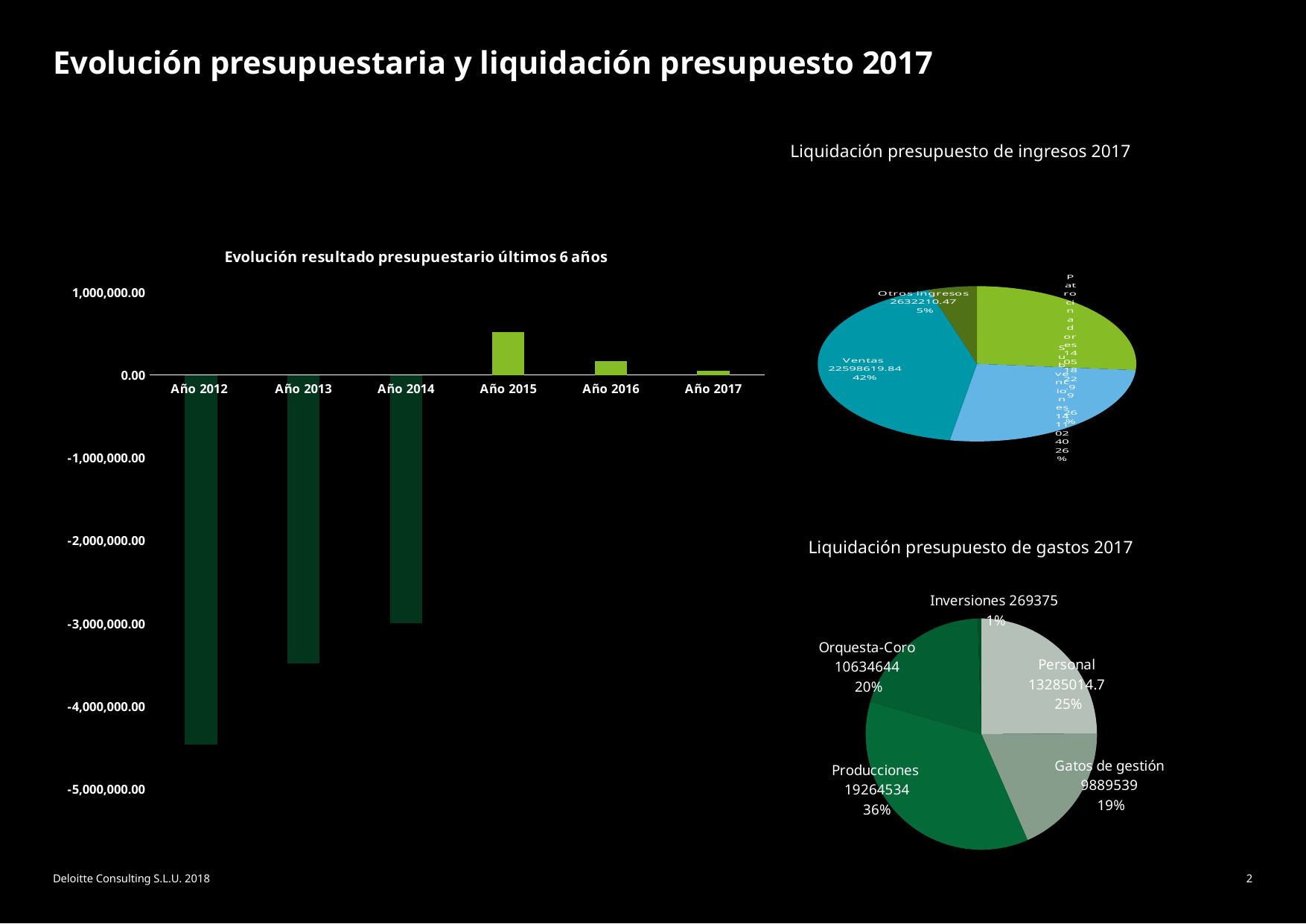
In the chart 'Evolución resultado presupuestario últimos 6 años', is the value for Año 2012 greater or less than -4,000,000.00? less In the pie chart 'Liquidación presupuesto de gastos 2017', what share does Personal represent? 25% In the pie chart 'Liquidación presupuesto de gastos 2017', what is the value for Producciones? 19264534 In the chart 'Evolución resultado presupuestario últimos 6 años', is the value for Año 2014 greater or less than -2,000,000.00? less In the chart 'Evolución resultado presupuestario últimos 6 años', which year has the lowest value? Año 2012 In the chart 'Evolución resultado presupuestario últimos 6 años', which year has the highest value? Año 2015 In the chart 'Evolución resultado presupuestario últimos 6 años', which is larger, the value for Año 2015 or Año 2016? Año 2015 What kind of chart is 'Evolución resultado presupuestario últimos 6 años'? bar chart In the chart 'Evolución resultado presupuestario últimos 6 años', how many years are plotted? 6 In the pie chart 'Liquidación presupuesto de gastos 2017', what is the difference between Producciones and Orquesta-Coro? 8629890 In the pie chart 'Liquidación presupuesto de gastos 2017', which category has the smallest slice? Inversiones In the pie chart 'Liquidación presupuesto de ingresos 2017', what share does Ventas represent? 42%